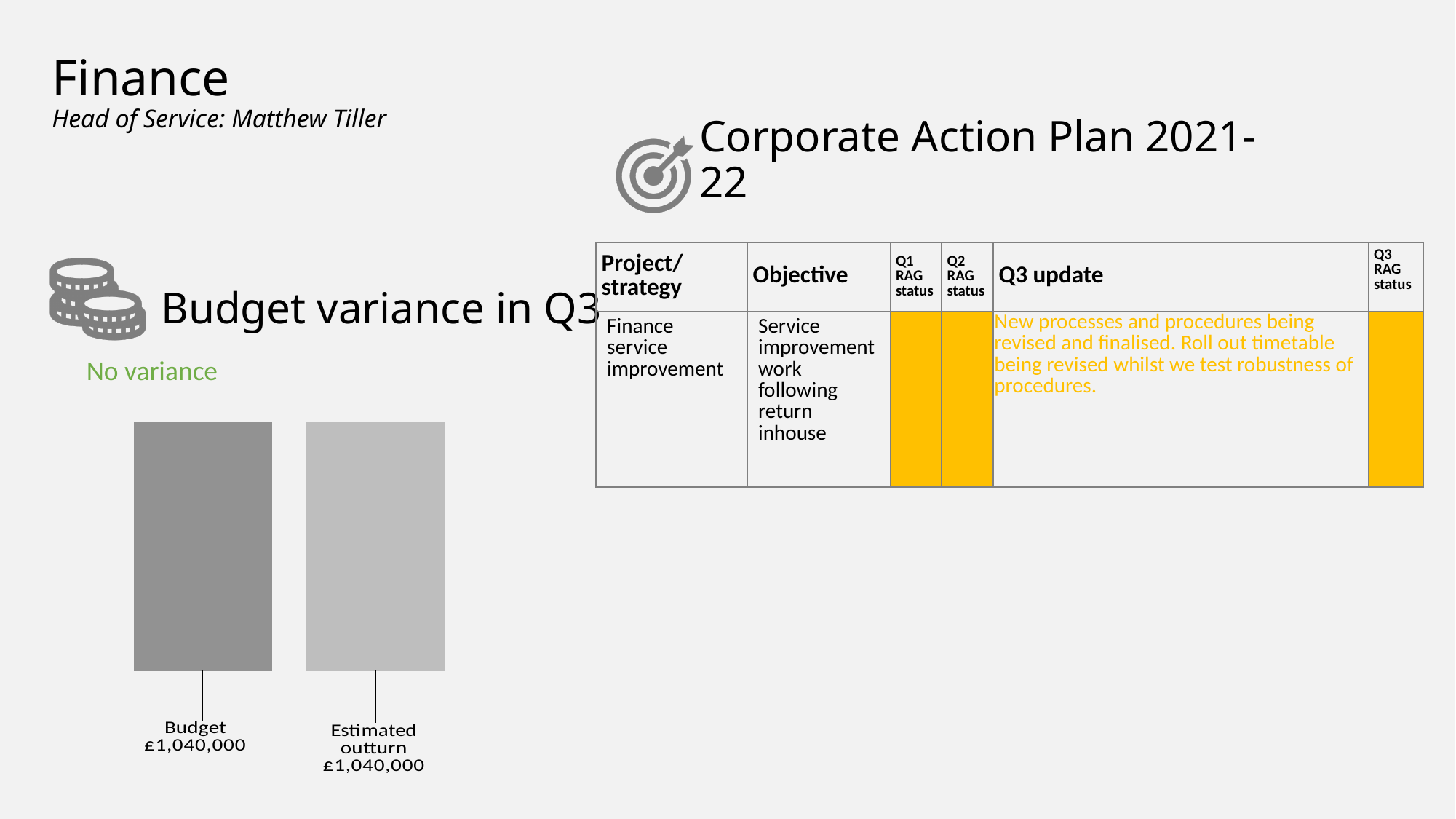
How many bars are plotted in the budget variance chart? 2 What is the value shown for Estimated outturn in the budget variance chart? £1,040,000 What is the value shown for Budget in the budget variance chart? £1,040,000 What are the two category labels on the budget variance chart? Budget and Estimated outturn What text in green appears above the budget variance chart describing the variance? No variance What kind of chart is shown under the heading "Budget variance in Q3"? Bar chart What is the difference between the Budget and the Estimated outturn values in the budget variance chart? £0 In the budget variance chart, is the Budget value larger than, smaller than, or equal to the Estimated outturn value? Equal